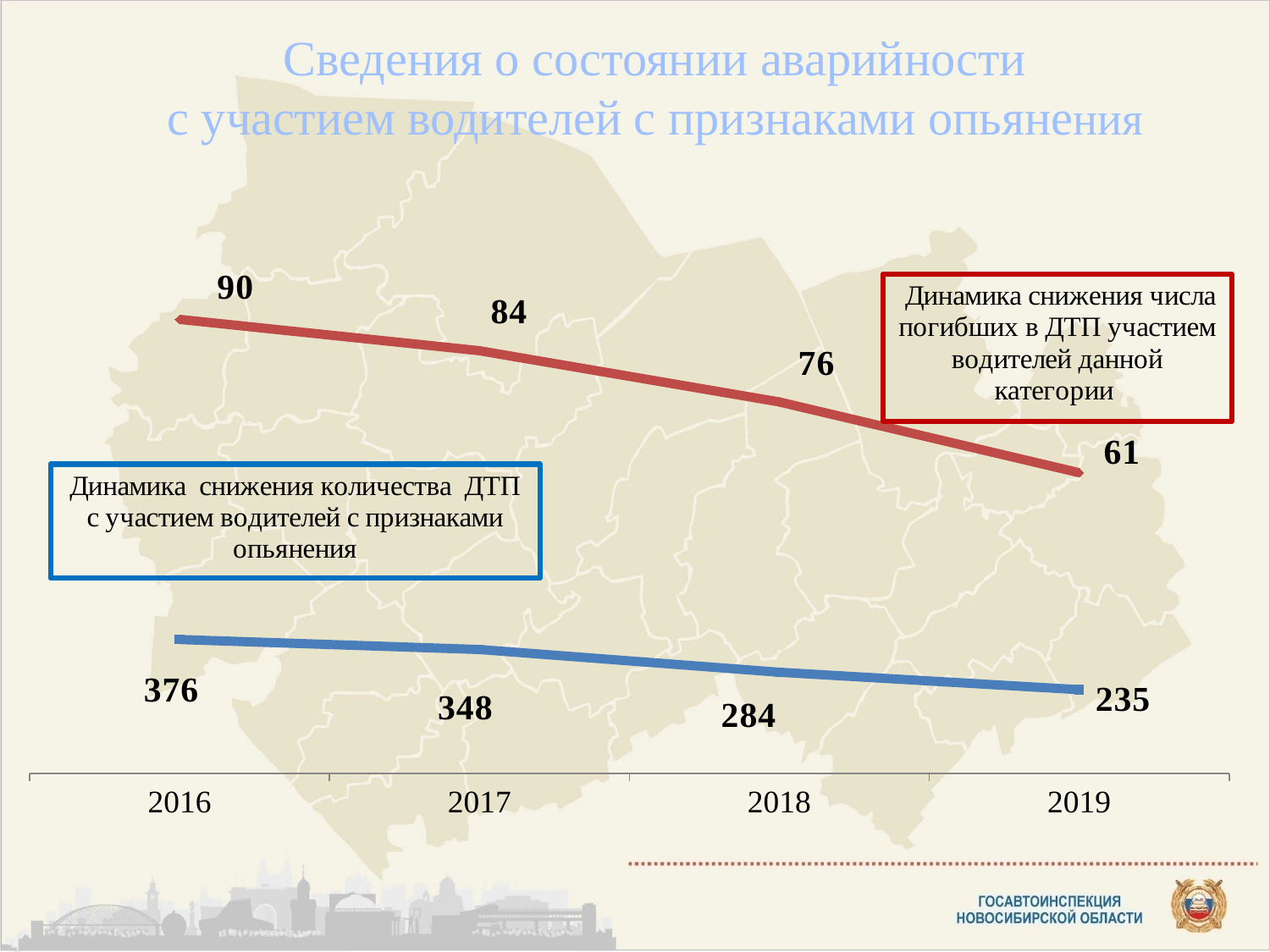
What is the number of deaths (погибших) in 2018? 76 Do the values of the blue line rise or fall from 2016 to 2019? fall What is the number of accidents (ДТП) in 2019? 235 How many years are shown on the x axis? 4 Which colour is the line showing the number of deaths (погибших)? red What is the number of accidents (ДТП) involving drivers with signs of intoxication in 2016? 376 What kind of chart is shown on the slide? line chart In which year is the number of accidents (ДТП) highest? 2016 What is the difference between the number of deaths in 2017 and in 2018? 8 By how much did the number of accidents (ДТП) fall from 2016 to 2019? 141 In which year is the number of deaths (погибших) lowest? 2019 What is the number of deaths (погибших) in 2017? 84